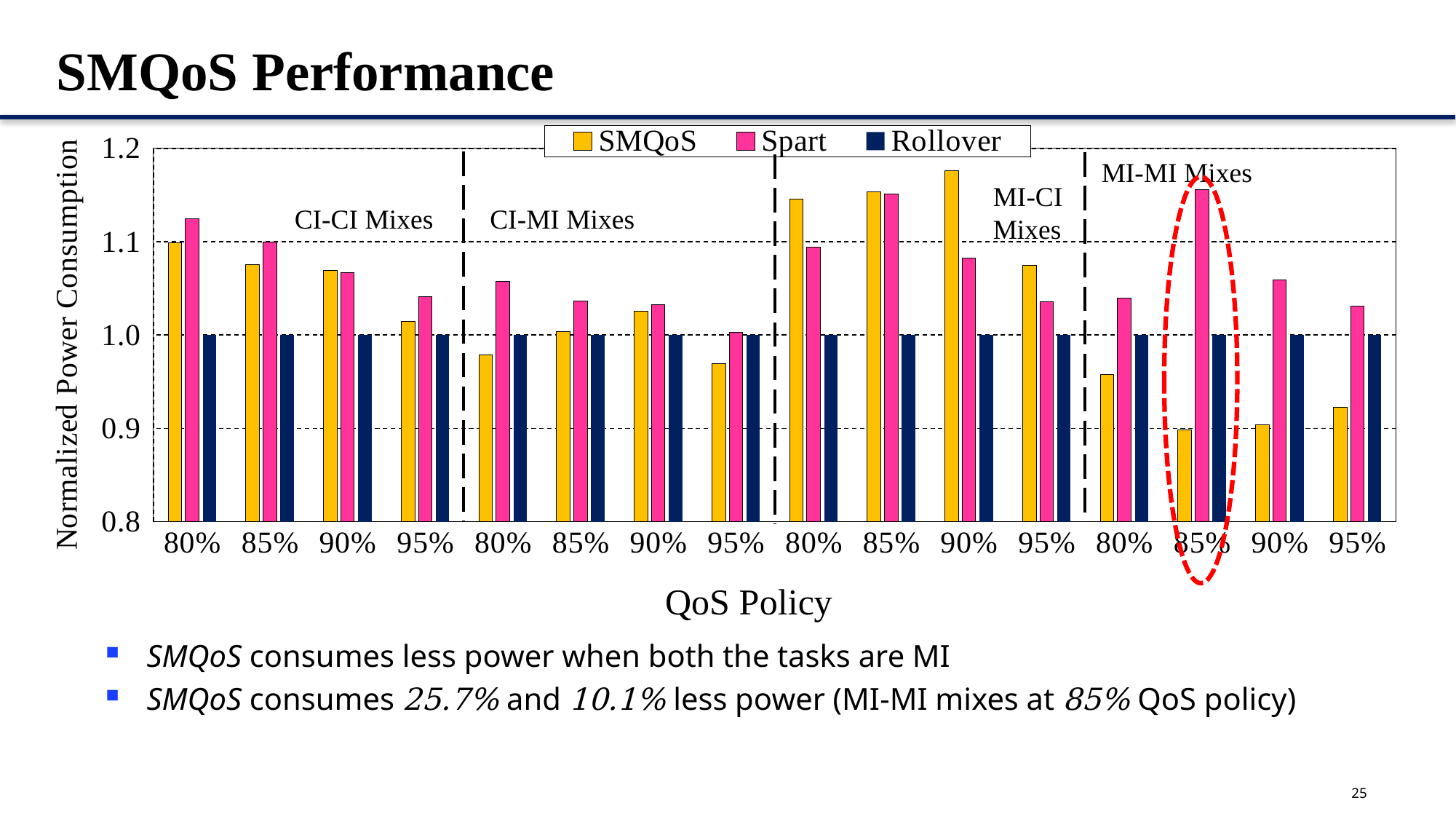
How many series does the legend list? 3 Is the SMQoS value at the 90% QoS policy in the MI-MI Mixes greater or less than 1.0? less Is the Spart value at the 85% QoS policy in the MI-MI Mixes greater or less than 1.1? greater Is the SMQoS value at the 90% QoS policy in the MI-CI Mixes greater or less than 1.1? greater What is the title of the y axis? Normalized Power Consumption At the 80% QoS policy in the MI-CI Mixes, which is larger, SMQoS or Spart? SMQoS At the 85% QoS policy in the MI-MI Mixes, which is larger, SMQoS or Spart? Spart What is the Rollover value at the 80% QoS policy in the CI-CI Mixes? 1.0 What kind of chart is shown on the slide? bar chart How many QoS policy groups are plotted along the x axis? 16 Do the SMQoS values rise or fall from 80% to 95% within the CI-CI Mixes? fall